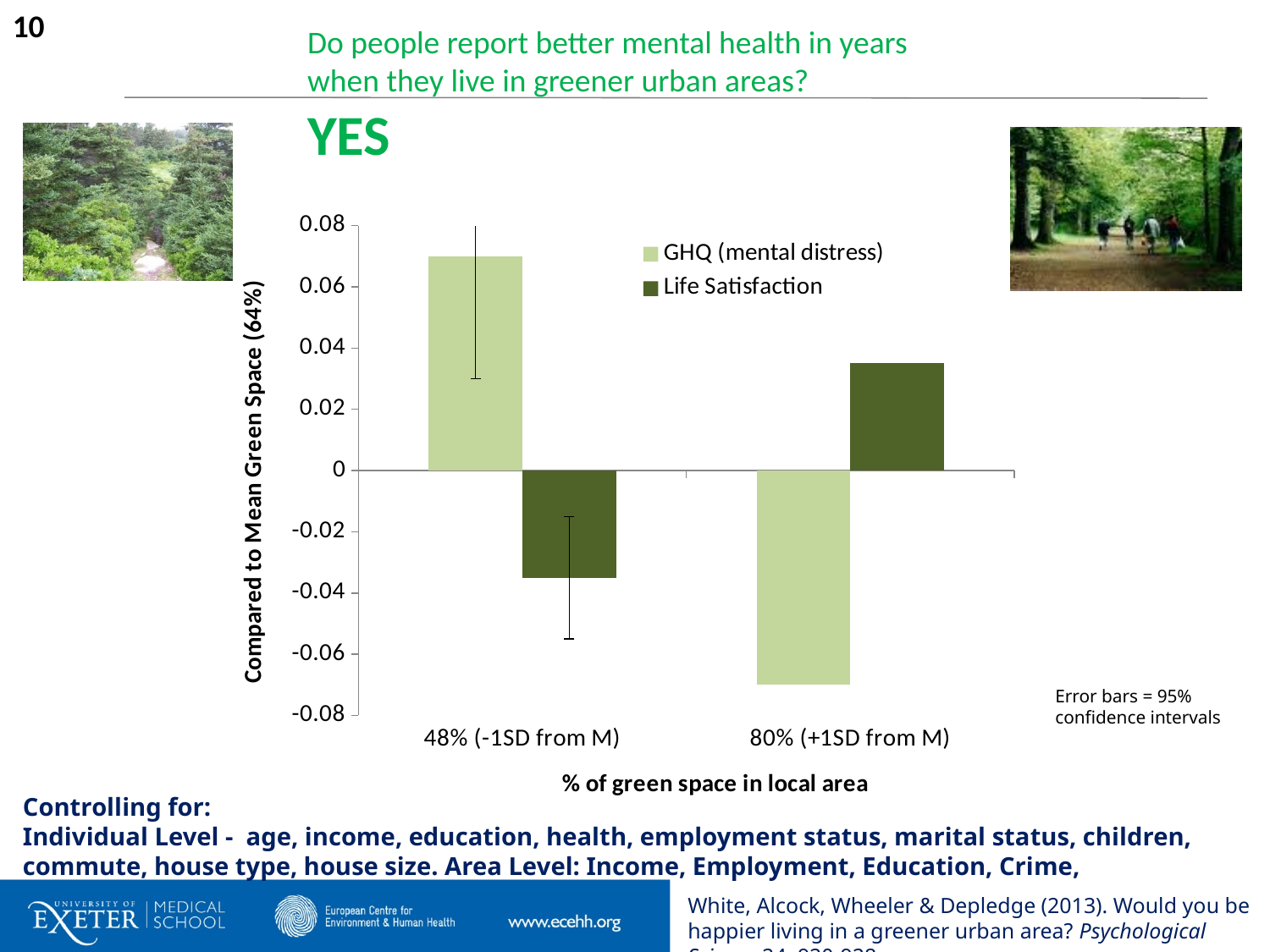
How many categories are shown on the x axis of the chart? 2 What kind of chart is shown on the slide? bar chart Is the Life Satisfaction value for 48% (-1SD from M) greater or less than -0.02? less Is the GHQ (mental distress) value for 48% (-1SD from M) greater or less than 0.06? greater According to the note next to the chart, what do the error bars represent? 95% confidence intervals How many series does the chart legend list? 2 Is the GHQ (mental distress) value for 80% (+1SD from M) greater or less than -0.06? less Which category has the highest Life Satisfaction value? 80% (+1SD from M) What is the title of the x axis of the chart? % of green space in local area Which category has the higher GHQ (mental distress) value, 48% (-1SD from M) or 80% (+1SD from M)? 48% (-1SD from M) Does the GHQ (mental distress) value rise or fall from 48% (-1SD from M) to 80% (+1SD from M)? fall